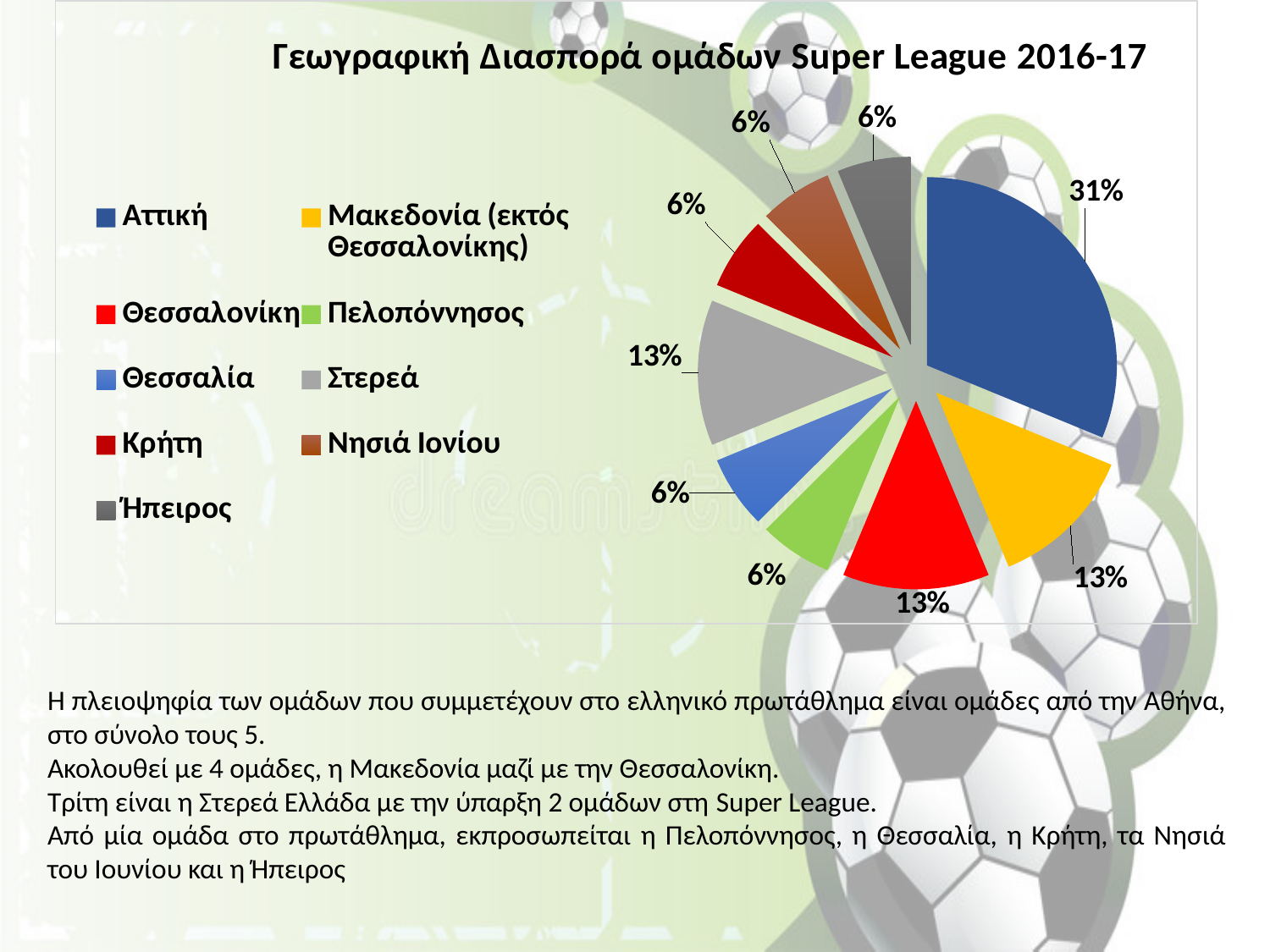
What is the value shown for Θεσσαλονίκη? 13% Which region has the largest slice of the pie? Αττική What colour is the slice for Πελοπόννησος? green What share of the pie does Αττική represent? 31% Which is larger, the share of Στερεά or the share of Θεσσαλία? Στερεά What is the value shown for Στερεά? 13% What type of chart is shown on the slide? pie chart What is the title of the chart? Γεωγραφική Διασπορά ομάδων Super League 2016-17 What is the value shown for Κρήτη? 6% What is the difference between the share of Αττική and the share of Μακεδονία (εκτός Θεσσαλονίκης)? 18% How many entries does the legend list? 9 How many slices does the pie chart have? 9